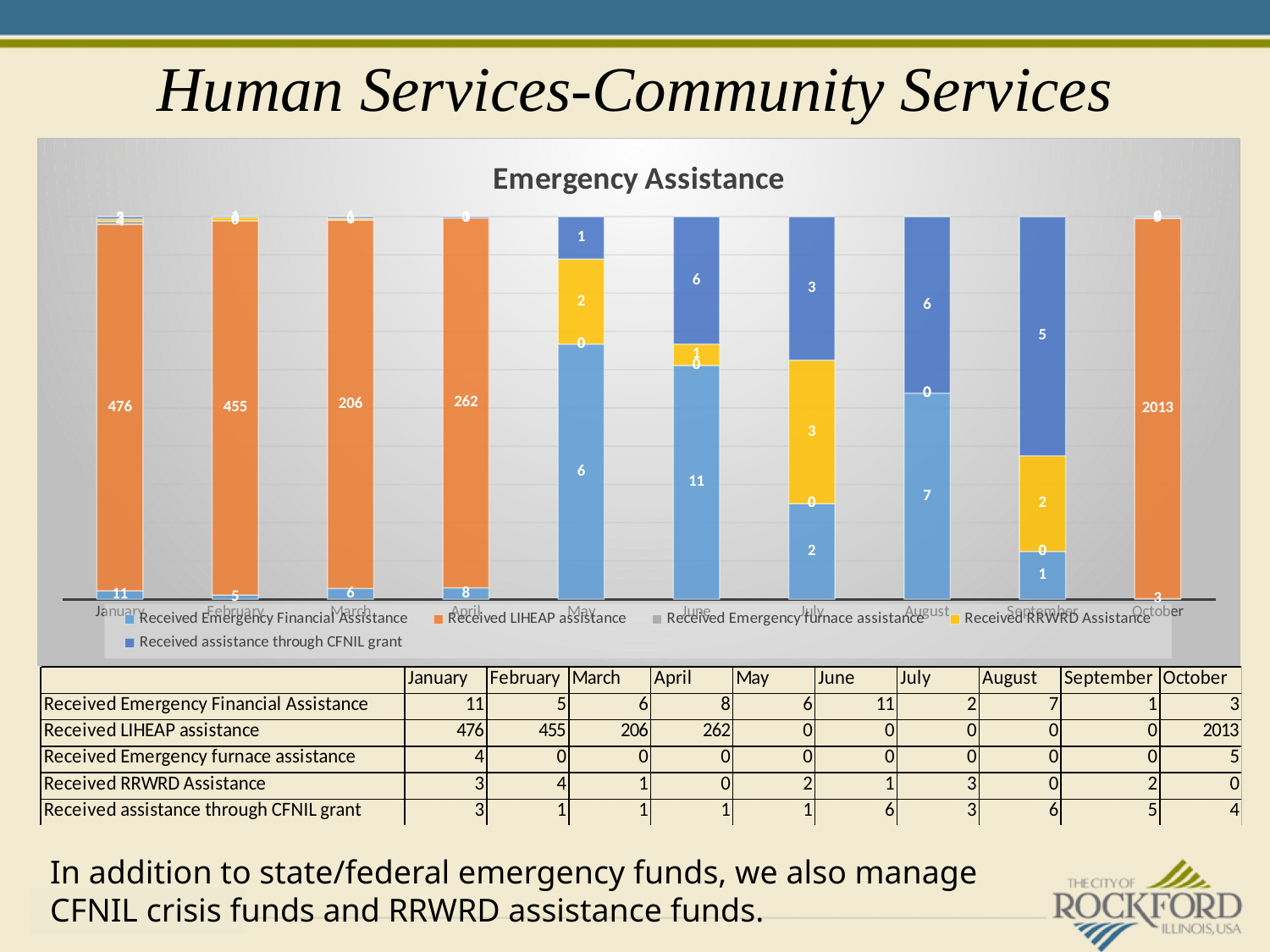
How many people Received Emergency Financial Assistance in June? 11 What is the total of all five series for January? 497 What is the value for Received LIHEAP assistance in October? 2013 What kind of chart is shown on the slide? Stacked bar chart What is the title of the chart? Emergency Assistance Which month has the larger value for Received assistance through CFNIL grant, June or July? June What is the difference between Received LIHEAP assistance in January and in February? 21 What is the value for Received RRWRD Assistance in July? 3 In which month is Received Emergency Financial Assistance lowest? September How many series does the legend list? 5 In which month is Received LIHEAP assistance highest? October How many months are shown on the x axis of the chart? 10